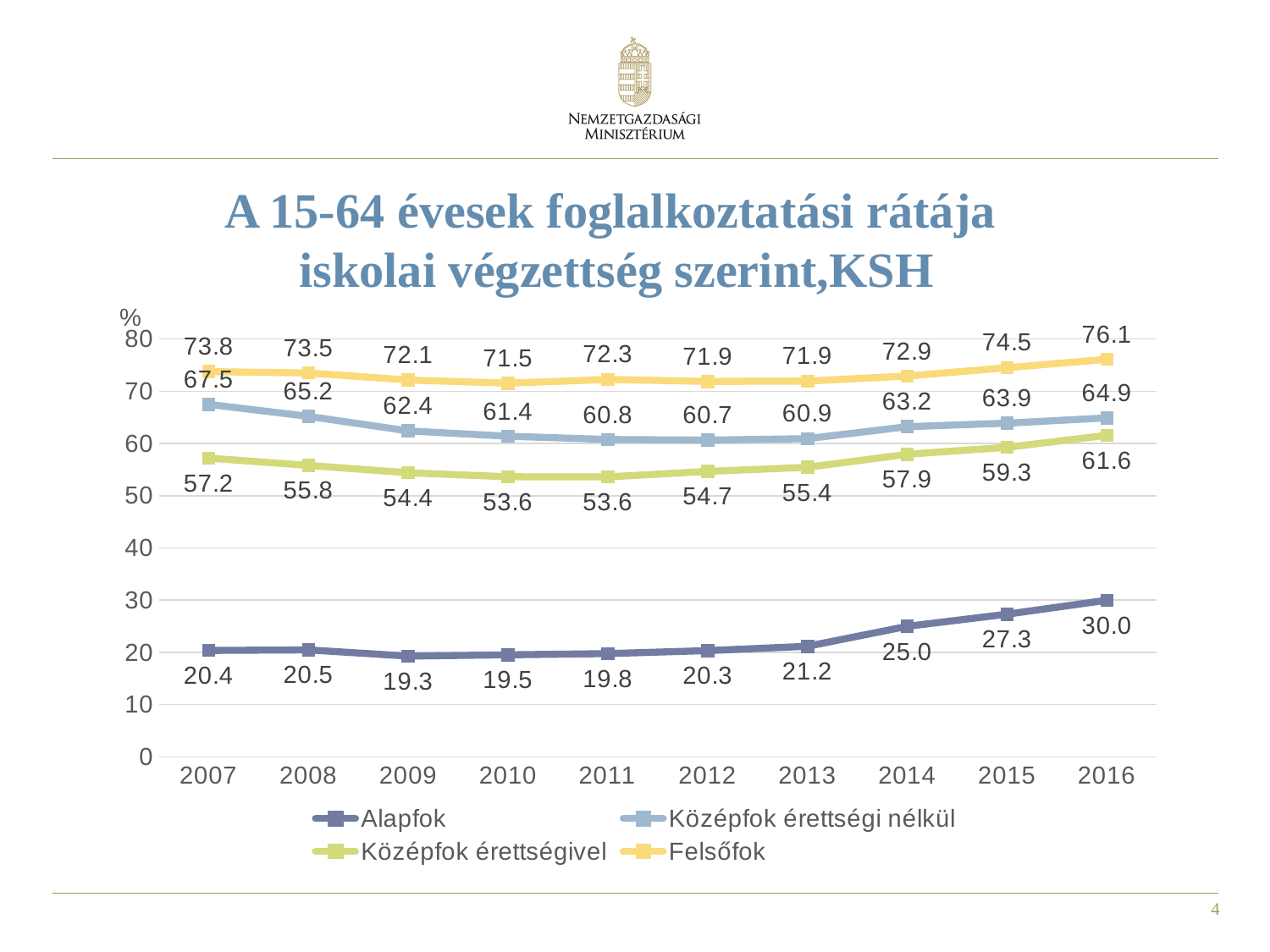
What is the value for Középfok érettségi nélkül in 2012? 60.7 Does the Alapfok series rise or fall from 2013 to 2016? rise What is the difference between the Felsőfok and Alapfok values in 2016? 46.1 What is the title of the chart? A 15-64 évesek foglalkoztatási rátája iskolai végzettség szerint,KSH How many series does the legend list? 4 In which year is the Alapfok value highest? 2016 Which is larger in 2007: Középfok érettségi nélkül or Középfok érettségivel? Középfok érettségi nélkül In which year is the Felsőfok value lowest? 2010 How many years are shown on the x axis? 10 What type of chart is shown on the slide? line chart What is the value for Felsőfok in 2016? 76.1 What is the value for Alapfok in 2009? 19.3